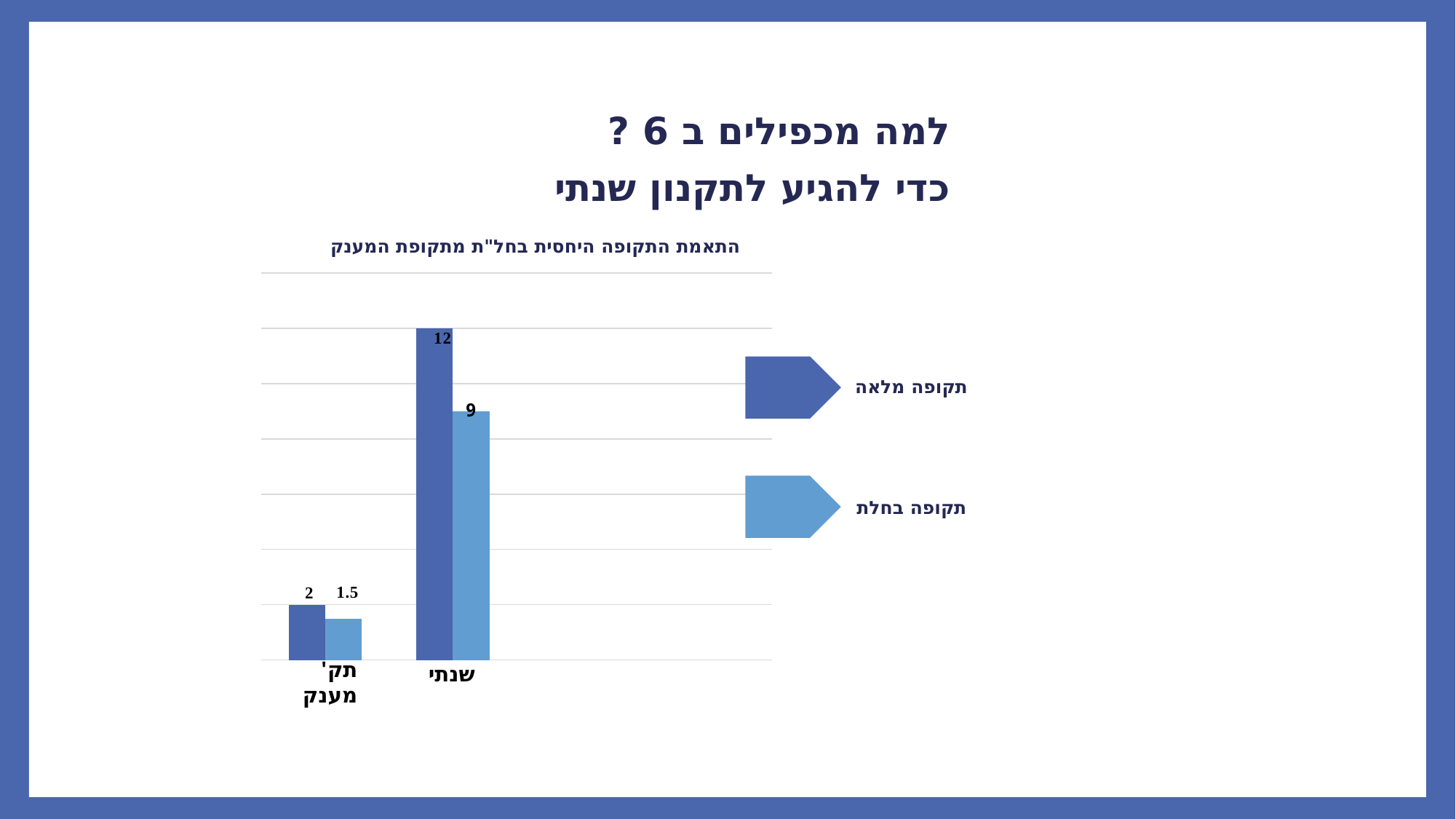
Which is larger for the שנתי category: תקופה מלאה or תקופה בחלת? תקופה מלאה Which category has the lowest תקופה בחלת value? תק' מענק What is the value of the תקופה בחלת bar for the תק' מענק category? 1.5 How many categories are shown on the x axis of the chart? 2 What is the value of the תקופה בחלת bar for the שנתי category? 9 What is the difference between the תקופה מלאה and תקופה בחלת values for שנתי? 3 What is the difference between the תקופה מלאה and תקופה בחלת values for תק' מענק? 0.5 What is the value of the תקופה מלאה bar for the שנתי category? 12 What is the value of the תקופה מלאה bar for the תק' מענק category? 2 How many series does the chart's legend list? 2 Which category has the highest תקופה מלאה value? שנתי What type of chart is shown on the slide? bar chart